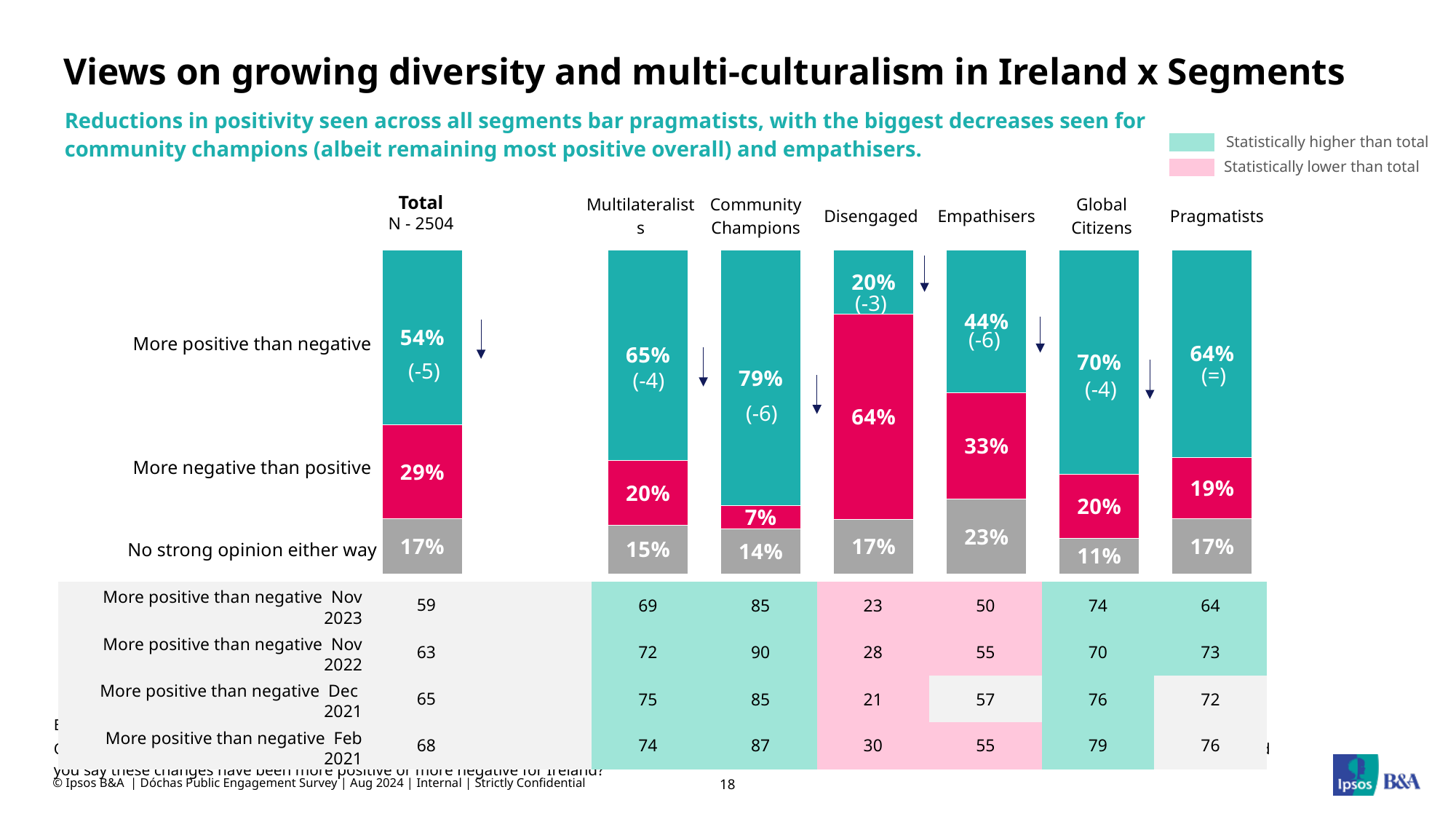
What type of chart is used to show the views by segment? Stacked bar chart What is the 'More positive than negative' value for the Total column? 54% Which segment has the lowest 'No strong opinion either way' share? Global Citizens What is the 'No strong opinion either way' value for Empathisers? 23% Which is larger: the 'More negative than positive' share for Empathisers or for Multilateralists? Empathisers Which segment has the lowest 'More positive than negative' share? Disengaged What percentage of Community Champions are 'More positive than negative'? 79% Which segment has the highest 'More positive than negative' share? Community Champions What is the difference between the 'More positive than negative' values for Global Citizens and Pragmatists? 6 percentage points How many segment columns (including Total) are shown in the bar chart? 7 What percentage of the Disengaged segment are 'More negative than positive'? 64% What is the sample size (N) shown for the Total column? 2504